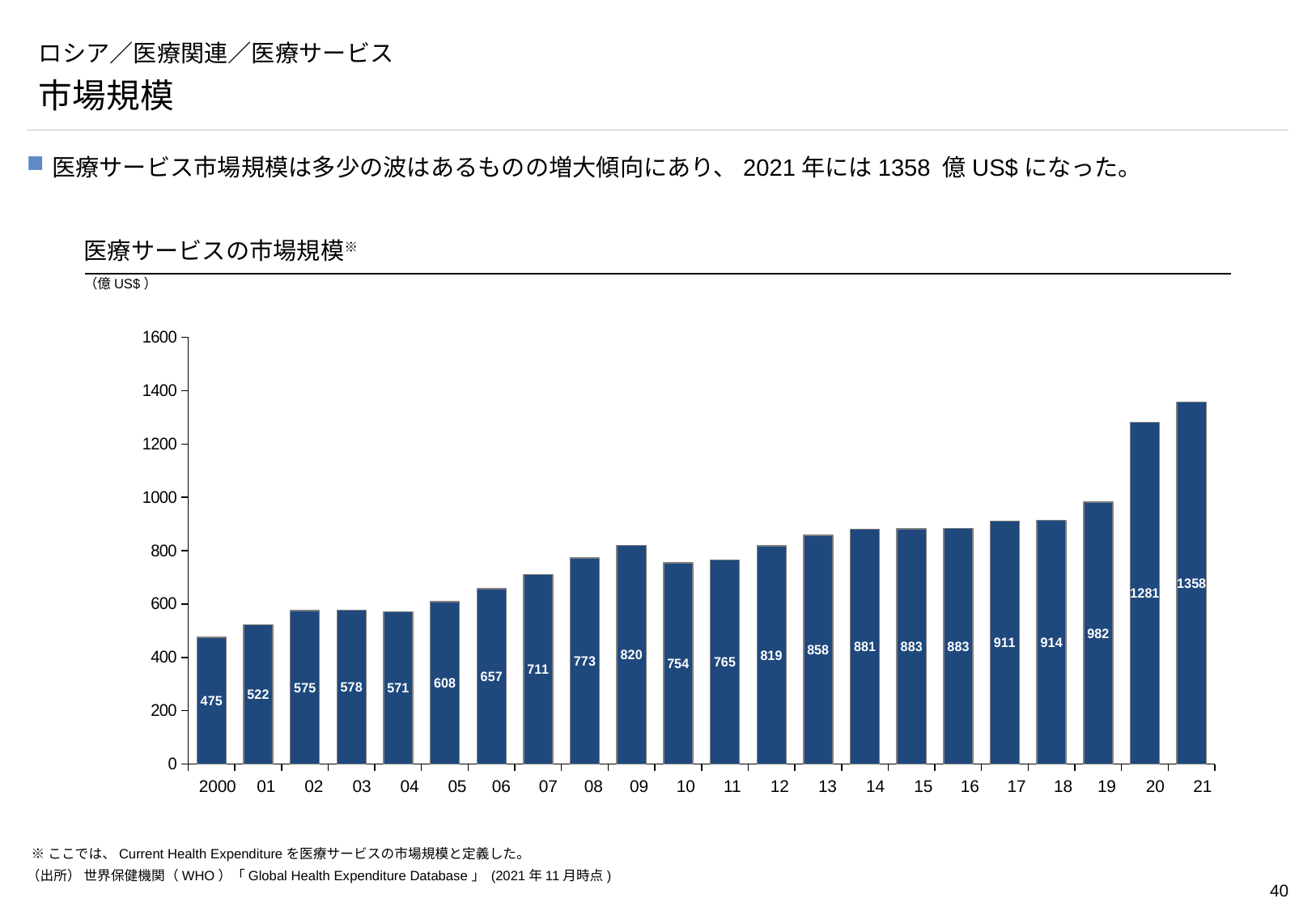
Is the value for 2019 greater or less than 1000? less What is the value for 2009 in the chart? 820 What unit is shown for the values in the chart? 億 US$ What is the value for 2000 in the chart? 475 What is the value for 2020 in the chart? 1281 Which year has the lowest value in the chart? 2000 Which is larger, the value for 2009 or the value for 2010? 2009 What is the difference between the values for 2021 and 2020? 77 How many bars are shown in the chart? 22 What kind of chart is shown on the slide? bar chart Which year has the highest value in the chart? 21 What is the value for 2021 in the 医療サービスの市場規模 chart? 1358